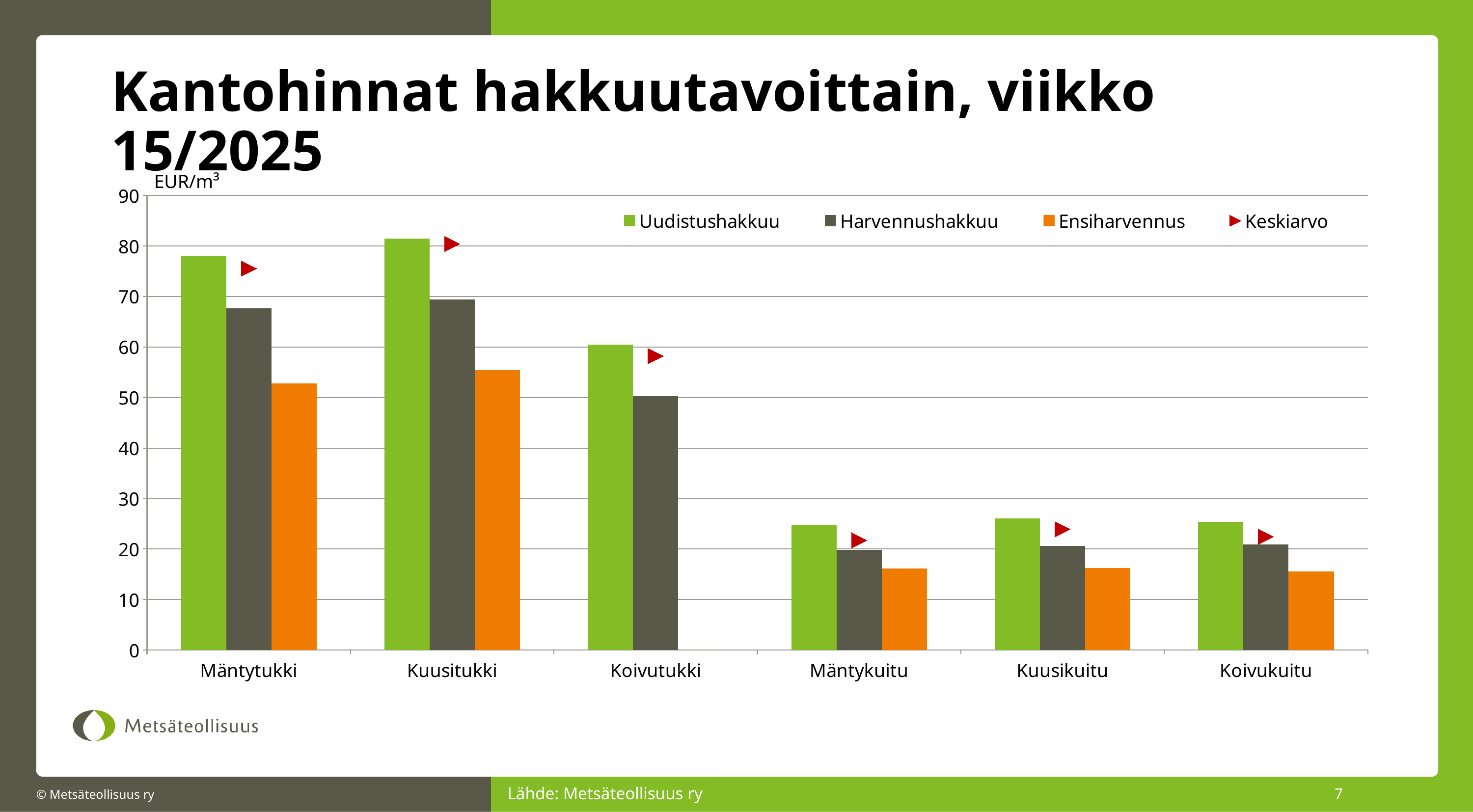
What kind of chart is shown on the slide? bar chart Which is larger: the Harvennushakkuu value for Kuusitukki or the Uudistushakkuu value for Koivutukki? Harvennushakkuu value for Kuusitukki Is the Ensiharvennus value for Kuusitukki greater or less than 60? less How many series does the legend list? 4 What unit is shown on the y axis of the chart? EUR/m³ Is the Uudistushakkuu value for Mäntytukki greater or less than 70? greater For Mäntytukki, which is larger: the Uudistushakkuu value or the Harvennushakkuu value? Uudistushakkuu Which category has no Ensiharvennus bar? Koivutukki How many categories are shown on the x axis? 6 Is the Harvennushakkuu value for Koivutukki greater or less than 60? less Which category has the highest Uudistushakkuu value? Kuusitukki